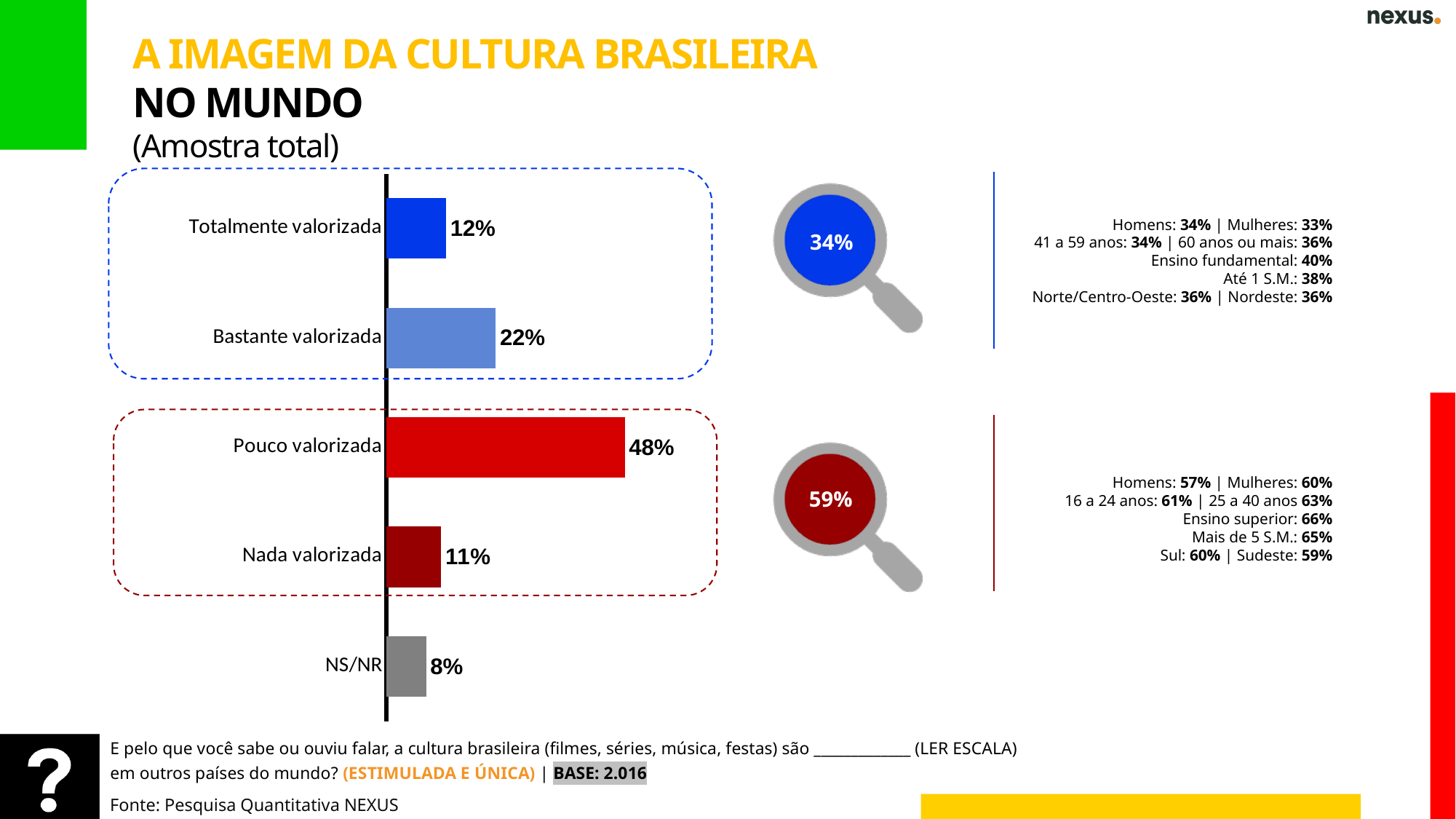
What kind of chart is shown on the slide? Bar chart How many categories are shown in the bar chart? 5 What is the value for "Totalmente valorizada"? 12% Which is larger, the value for "Totalmente valorizada" or the value for "Nada valorizada"? Totalmente valorizada What colour is the bar for "Pouco valorizada"? Red What is the combined value of "Totalmente valorizada" and "Bastante valorizada"? 34% What is the value for "Bastante valorizada"? 22% Which category has the lowest value? NS/NR Which category has the highest value? Pouco valorizada What is the value for "Pouco valorizada"? 48% What is the difference between the values for "Pouco valorizada" and "Bastante valorizada"? 26% What is the value for "NS/NR"? 8%